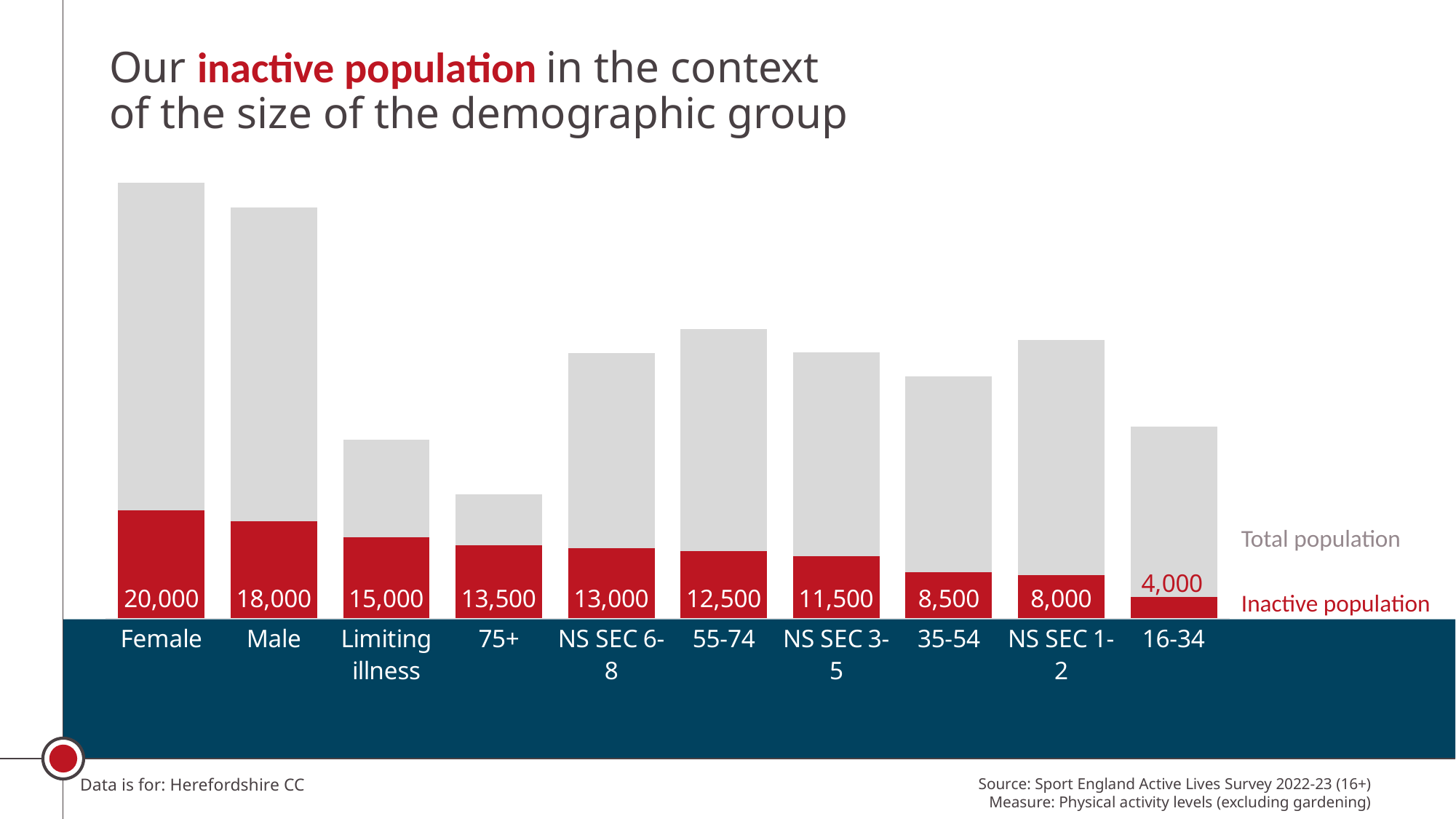
How many demographic groups are shown on the chart? 10 Which has a larger inactive population, the 55-74 group or the 35-54 group? 55-74 What is the inactive population for the 16-34 group? 4,000 How many series does the chart show? 2 What is the inactive population for the NS SEC 3-5 group? 11,500 Which group has a larger total population, Female or 16-34? Female What type of chart is shown on the slide? Stacked bar chart What is the inactive population for the Female group? 20,000 What is the difference between the inactive population of the Female group and the Male group? 2,000 What is the difference between the inactive population of the 35-54 group and the 16-34 group? 4,500 Which demographic group has the lowest inactive population? 16-34 Which demographic group has the highest inactive population? Female